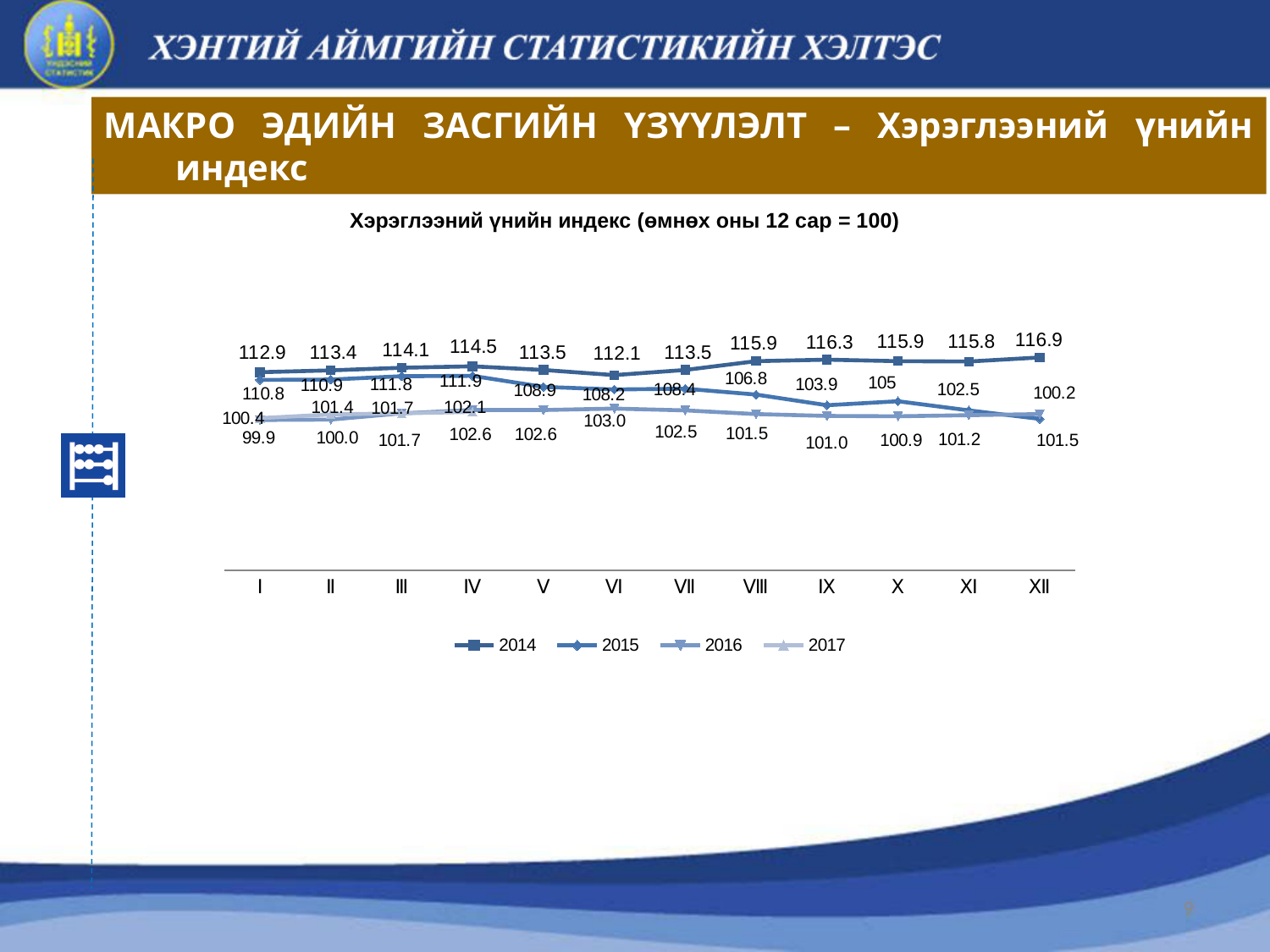
What is the difference between the 2014 values for month XII and month I? 4.0 In which month is the 2014 series highest? XII How many months (categories) are shown on the x axis? 12 What is the 2014 value for month XII? 116.9 How many series does the legend list? 4 Which series has the larger value in month IX, 2014 or 2015? 2014 What is the 2015 value for month VIII? 106.8 What is the 2014 value for month I? 112.9 Does the 2015 series generally rise or fall from month I to month XII? fall In which month is the 2014 series lowest? VI What is the 2015 value for month XII? 100.2 What kind of chart is shown on the slide? line chart